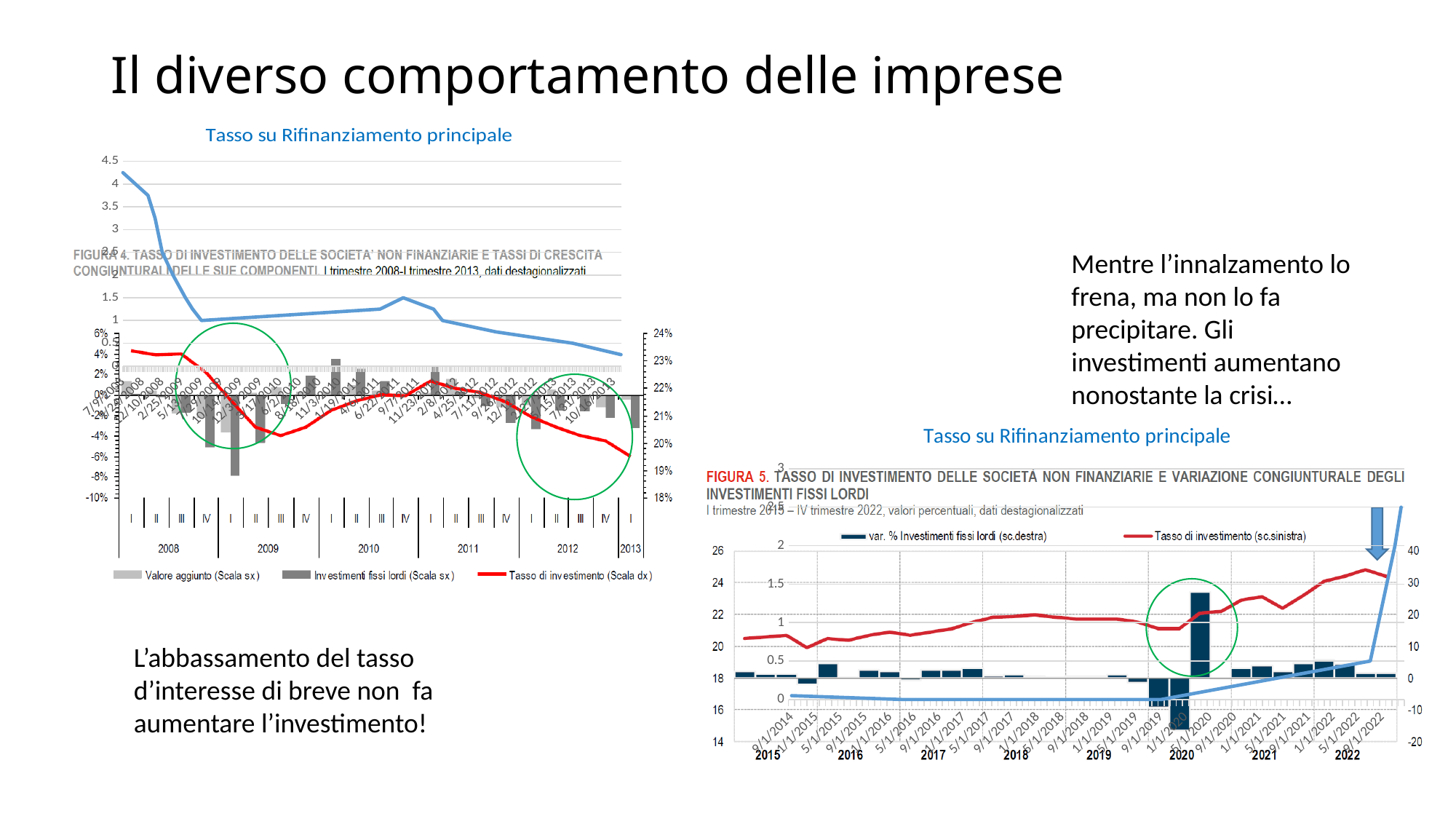
In Figura 4, in which year does the lowest (most negative) bar for 'Investimenti fissi lordi' occur? 2009 In Figura 5, does the red 'Tasso di investimento' line overall rise or fall from 2015 to 2022? rise What kind of chart is the left 'Tasso su Rifinanziamento principale' chart? line chart In the left 'Tasso su Rifinanziamento principale' chart, is the final value in 2013 greater or less than 1? less How many series does the legend of Figura 5 list? 2 In the left 'Tasso su Rifinanziamento principale' chart, is the starting value in 2008 greater or less than 4? greater In the right 'Tasso su Rifinanziamento principale' chart, is the final value at the end of 2022 greater or less than 2? greater In the right 'Tasso su Rifinanziamento principale' chart, does the blue line rise or fall at the end of the period in 2022? rise In Figura 4, what colour is the 'Tasso di investimento (Scala dx)' line? red In Figura 5, in which year does the tallest bar for 'var. % Investimenti fissi lordi' occur? 2020 In the left 'Tasso su Rifinanziamento principale' chart, does the blue line overall rise or fall from 2008 to 2013? fall How many series does the legend of Figura 4 list? 3